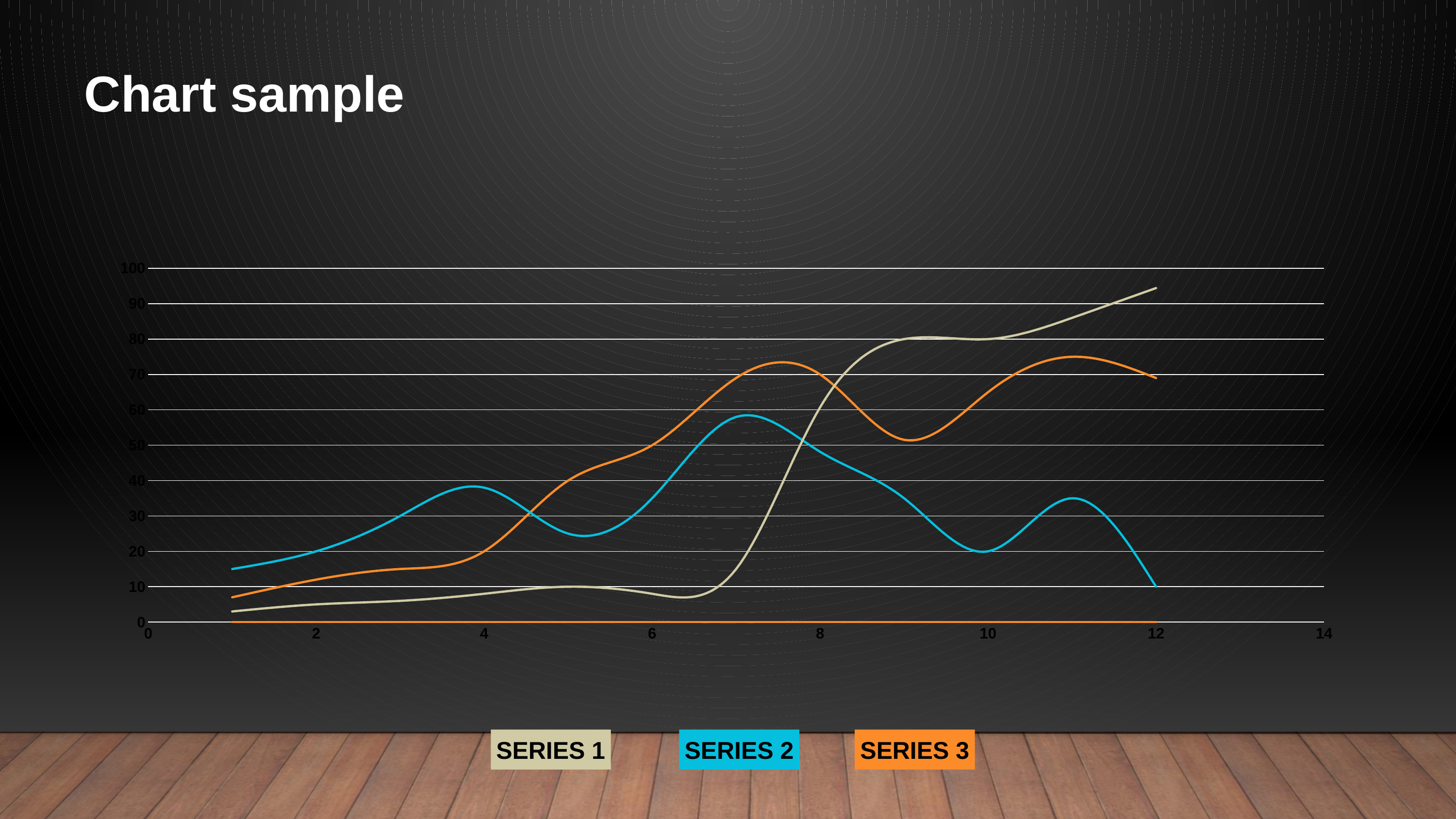
Is the value of Series 3 at x = 12 greater or less than 60? greater What is the title of the chart on the slide? Chart sample At x = 12, which is higher, Series 1 or Series 3? Series 1 Which series reaches the highest value on the chart? Series 1 Does Series 1 overall rise or fall from x = 1 to x = 12? rise Which colour is used for Series 2 in the legend? blue How many series does the legend list? 3 Is the value of Series 2 at x = 12 greater or less than 20? less Is the value of Series 1 at x = 1 greater or less than 10? less What kind of chart is shown on the slide? line chart At x = 12, which is higher, Series 2 or Series 3? Series 3